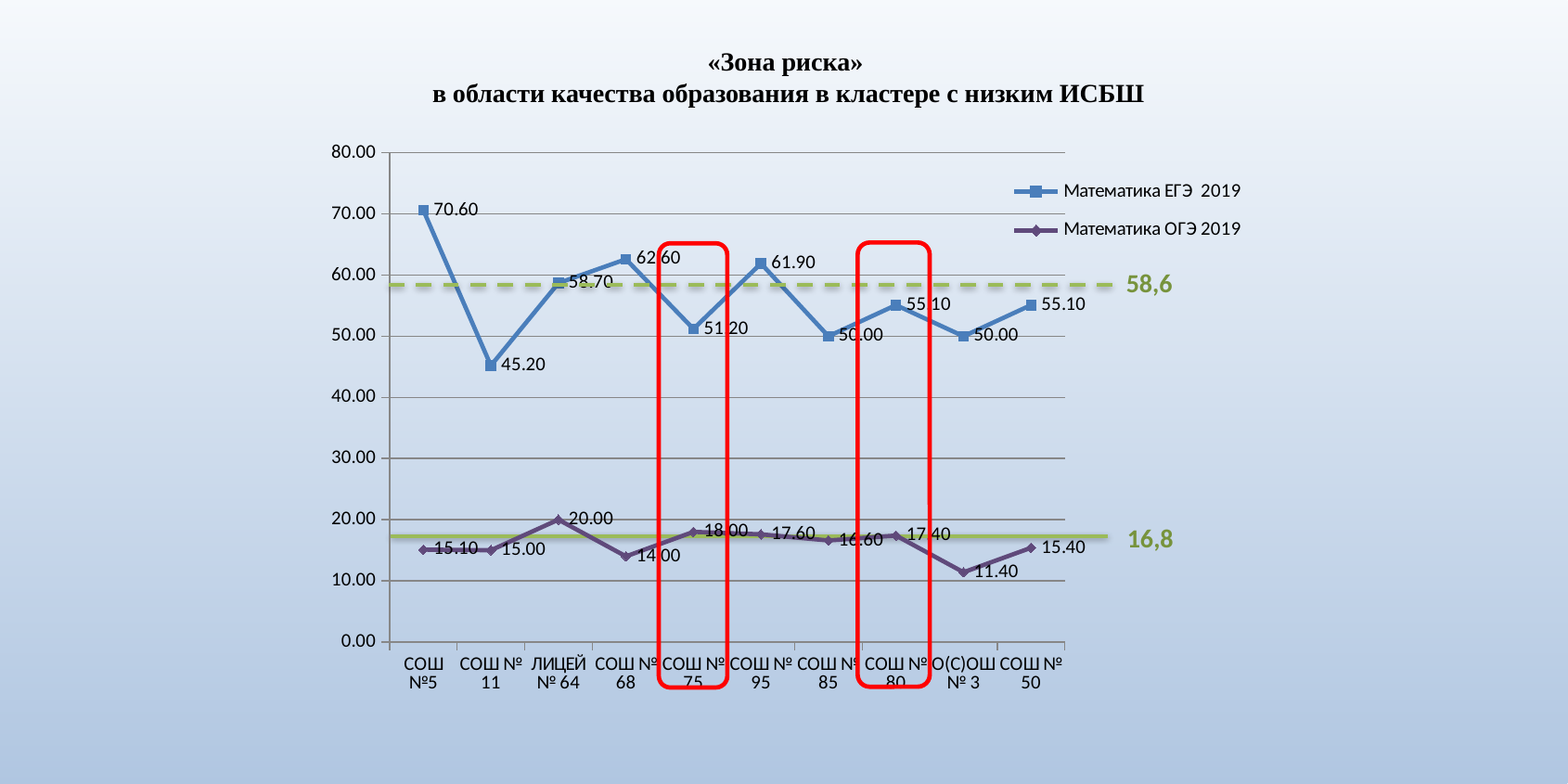
What value is labelled on the dashed green reference line for the ЕГЭ series? 58,6 Which school has the lowest Математика ЕГЭ 2019 value? СОШ № 11 Which school has the lowest Математика ОГЭ 2019 value? О(С)ОШ № 3 What type of chart is shown on the slide? line chart Which school has the highest Математика ОГЭ 2019 value? ЛИЦЕЙ № 64 Which is larger, the Математика ЕГЭ 2019 value for СОШ № 68 or for СОШ № 95? СОШ № 68 What is the difference between the Математика ЕГЭ 2019 values for СОШ №5 and СОШ № 11? 25.40 What is the Математика ЕГЭ 2019 value for СОШ № 75? 51.20 How many schools (categories) are plotted along the x axis? 10 What is the Математика ЕГЭ 2019 value for СОШ №5? 70.60 How many series does the legend list? 2 What is the Математика ОГЭ 2019 value for ЛИЦЕЙ № 64? 20.00